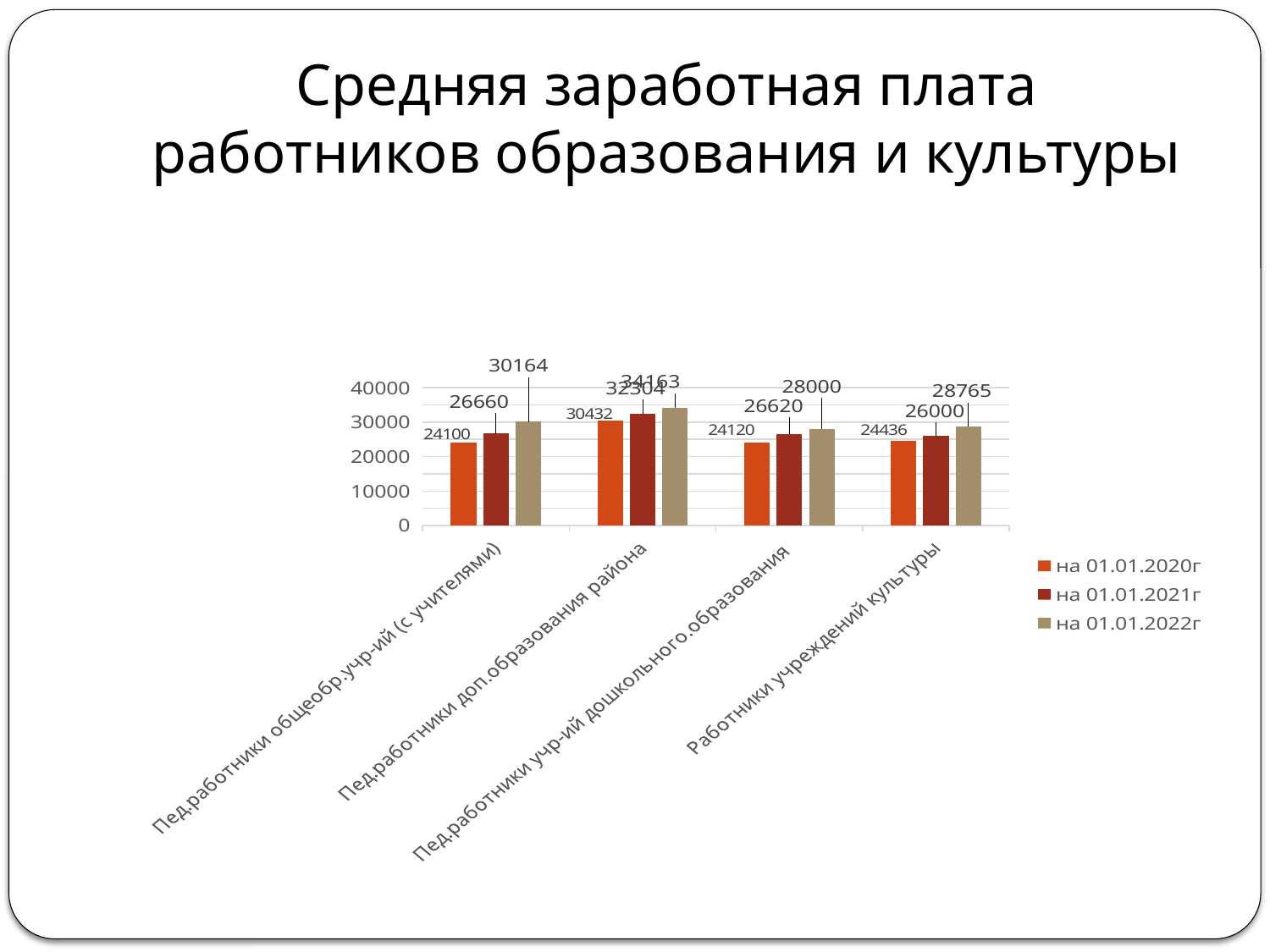
What is the title of the chart? Средняя заработная плата работников образования и культуры What is the value for Пед.работники общеобр.учр-ий (с учителями) на 01.01.2020г? 24100 What is the value for Пед.работники доп.образования района на 01.01.2022г? 34163 What kind of chart is shown on the slide? bar chart How many series does the legend list? 3 What is the value for Работники учреждений культуры на 01.01.2021г? 26000 How many categories are shown on the x axis? 4 What is the value for Пед.работники учр-ий дошкольного.образования на 01.01.2022г? 28000 Which is larger for Работники учреждений культуры: the value на 01.01.2022г or the value на 01.01.2020г? на 01.01.2022г Which category has the lowest value на 01.01.2020г? Пед.работники общеобр.учр-ий (с учителями) What is the difference between the values на 01.01.2022г and на 01.01.2020г for Пед.работники общеобр.учр-ий (с учителями)? 6064 Which category has the highest value на 01.01.2022г? Пед.работники доп.образования района